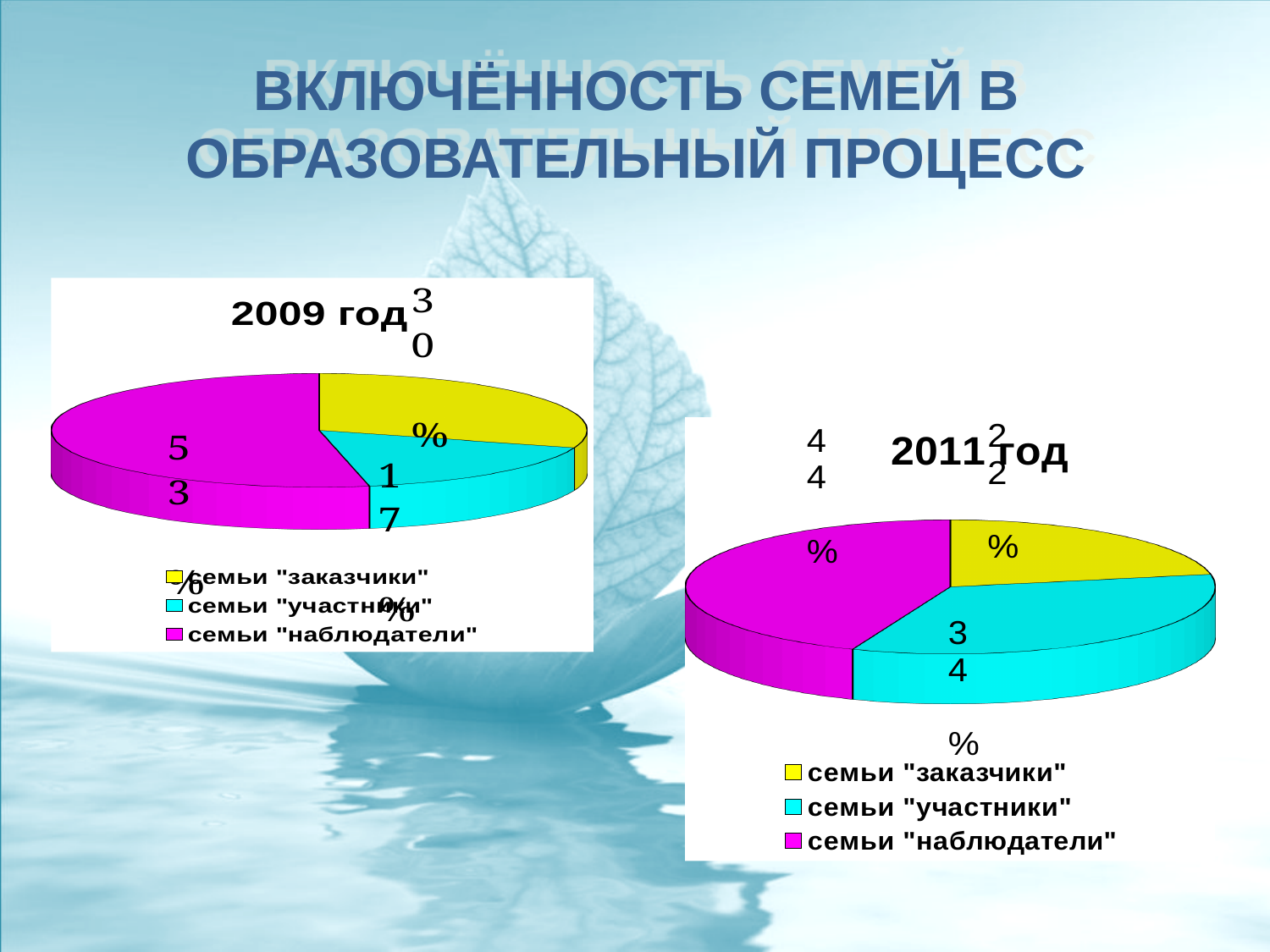
In the "2009 год" chart, which category has the smallest slice? семьи "участники" In the "2011 год" chart, what share is shown for семьи "участники"? 34% In the "2011 год" chart, which category has the largest slice? семьи "наблюдатели" In the "2011 год" chart, which slice is larger: семьи "участники" or семьи "заказчики"? семьи "участники" In the "2009 год" chart, what share is shown for семьи "наблюдатели"? 53% How many slices does the "2009 год" pie chart have? 3 In the "2011 год" chart, which category has the smallest slice? семьи "заказчики" What kind of chart is the "2011 год" chart? pie chart What kind of chart is the "2009 год" chart? pie chart How many entries does the legend of the "2011 год" chart list? 3 Which colour represents семьи "заказчики" in the legends of both charts? yellow In the "2009 год" chart, which category has the largest slice? семьи "наблюдатели"